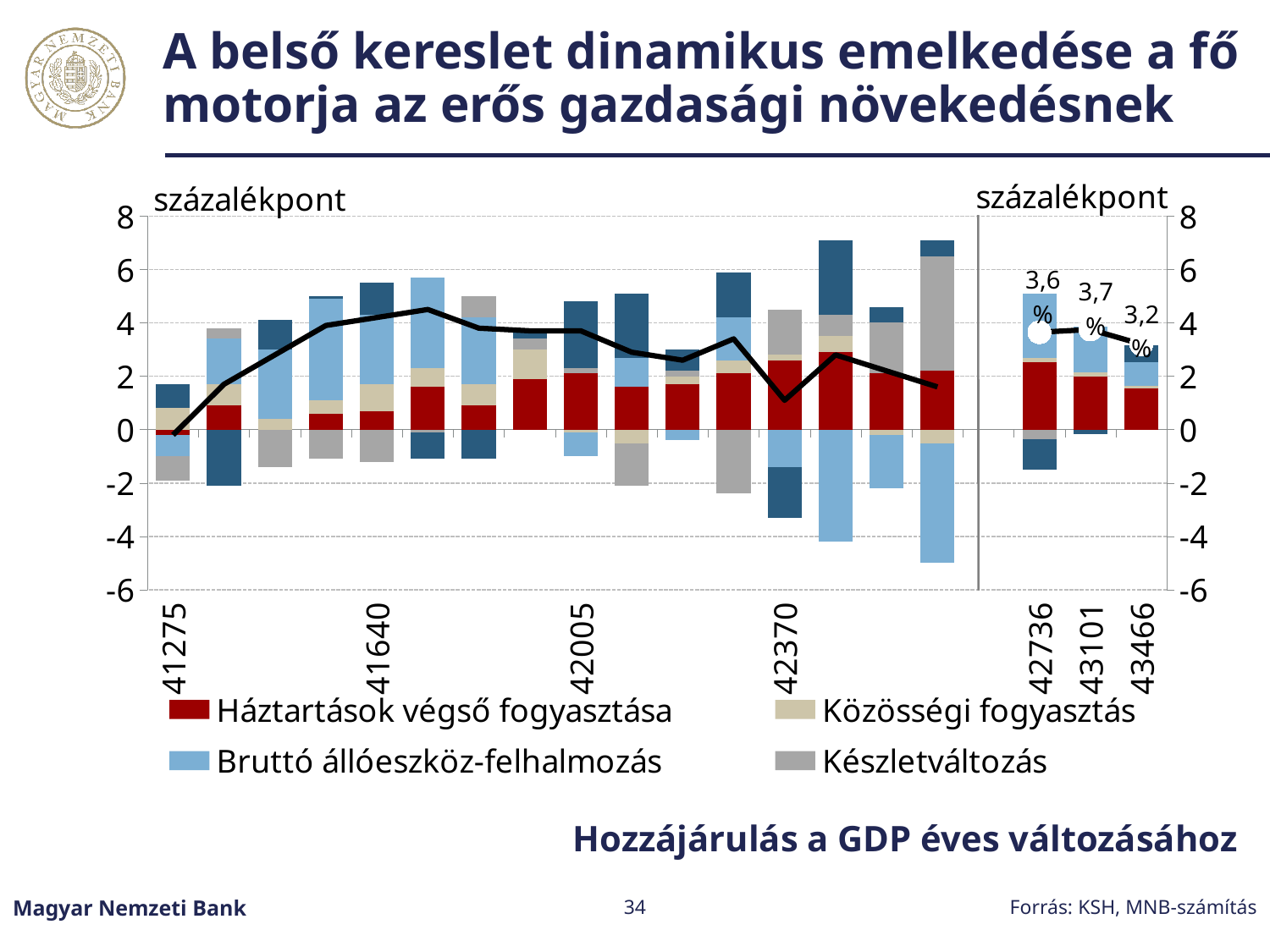
Among the three labelled points (42736, 43101, 43466), which has the lowest value? 43466 Is the value of the black line at 42370 greater or less than 2? less How many series does the legend list? 4 What kind of chart is shown on the slide? combination stacked bar and line chart Which labelled value is larger, the one for 42736 or the one for 43466? 42736 Does the black line rise or fall between 41275 and 41640? rise Among the three labelled points (42736, 43101, 43466), which has the highest value? 43101 What unit is written at the top of the vertical axes? százalékpont What value is labelled on the line for 43466? 3,2% What is the difference between the labelled values for 43101 and 43466? 0,5 What value is labelled on the line for 43101? 3,7% What value is labelled on the line for 42736? 3,6%